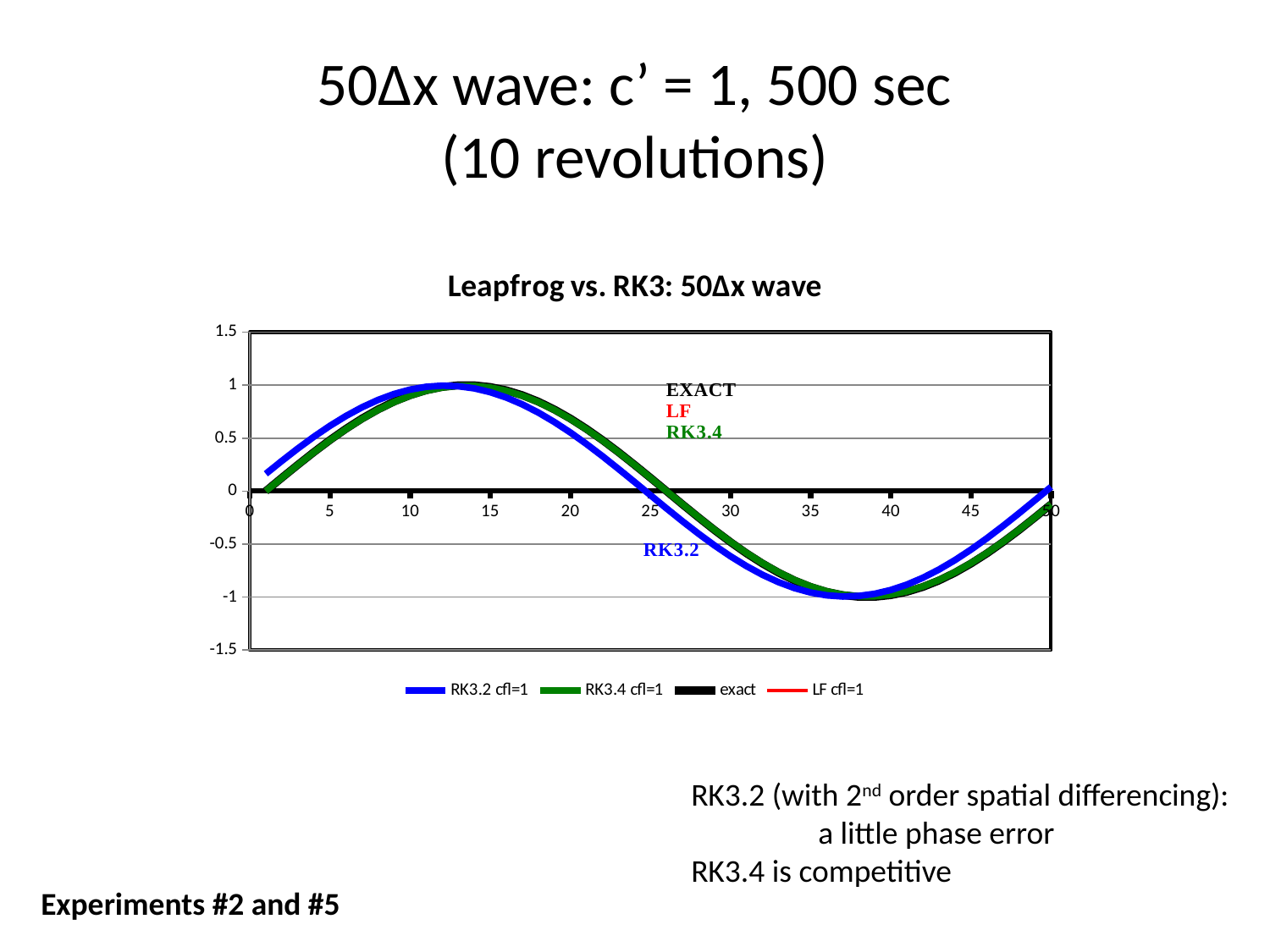
How many series does the legend of the chart list? 4 What is the title of the chart? Leapfrog vs. RK3: 50Δx wave Is the value of the exact series at x = 13 greater or less than 0.5? greater Is the value of the RK3.4 cfl=1 series at x = 10 greater or less than 0.5? greater Does the exact series rise or fall between x = 13 and x = 38? fall Which series is drawn in blue in the chart? RK3.2 cfl=1 Is the value of the exact series at x = 38 greater or less than -0.5? less At x = 45, which is larger: the RK3.2 cfl=1 series or the RK3.4 cfl=1 series? RK3.2 cfl=1 At x = 20, which is larger: the exact series or the RK3.2 cfl=1 series? exact What kind of chart is shown on the slide? line chart Does the exact series rise or fall between x = 0 and x = 13? rise